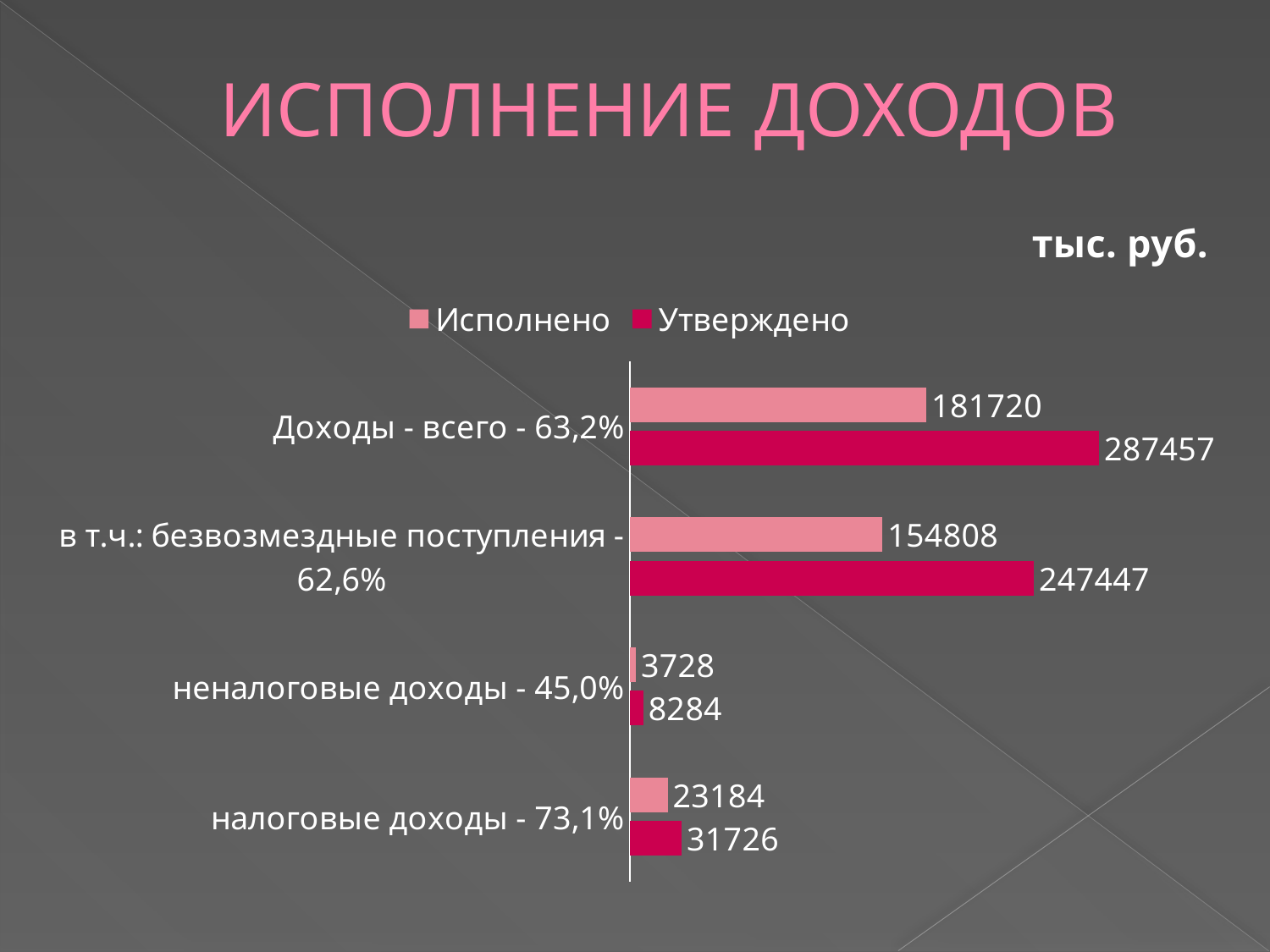
What is the difference between the Утверждено and Исполнено values for "Доходы - всего - 63,2%"? 105737 What is the Утверждено value for "в т.ч.: безвозмездные поступления - 62,6%"? 247447 What is the Исполнено value for "налоговые доходы - 73,1%"? 23184 Which category has the highest Утверждено value? Доходы - всего - 63,2% What is the difference between the Утверждено and Исполнено values for "налоговые доходы - 73,1%"? 8542 Which is larger: the Исполнено value for "налоговые доходы - 73,1%" or the Утверждено value for "неналоговые доходы - 45,0%"? Исполнено for налоговые доходы - 73,1% Which category has the lowest Исполнено value? неналоговые доходы - 45,0% What is the Исполнено value for "Доходы - всего - 63,2%"? 181720 What kind of chart is shown on the slide? bar chart How many series does the legend list? 2 How many categories are shown on the chart? 4 What is the Утверждено value for "неналоговые доходы - 45,0%"? 8284